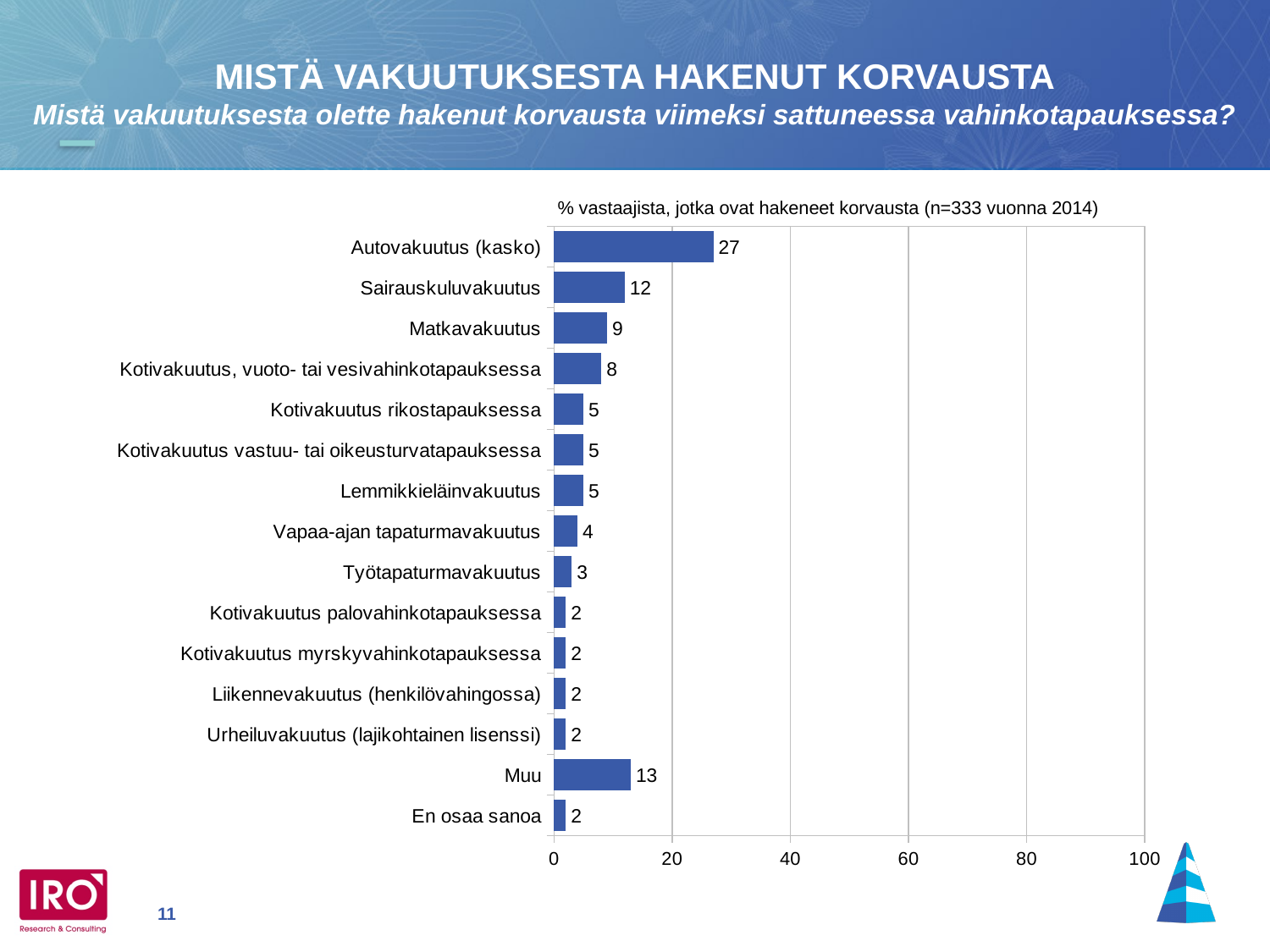
What is the difference between the values for Autovakuutus (kasko) and Sairauskuluvakuutus? 15 What is the maximum value shown on the horizontal axis? 100 How many categories are shown in the chart? 15 What kind of chart is shown on the slide? Bar chart Is the value for Autovakuutus (kasko) greater or less than 20? greater What is the value for Autovakuutus (kasko)? 27 What is the value for Muu? 13 Which category has the highest value? Autovakuutus (kasko) What is the value for Matkavakuutus? 9 Which is larger, the value for Muu or the value for Sairauskuluvakuutus? Muu What is the value for Työtapaturmavakuutus? 3 What is the difference between the values for Muu and Vapaa-ajan tapaturmavakuutus? 9